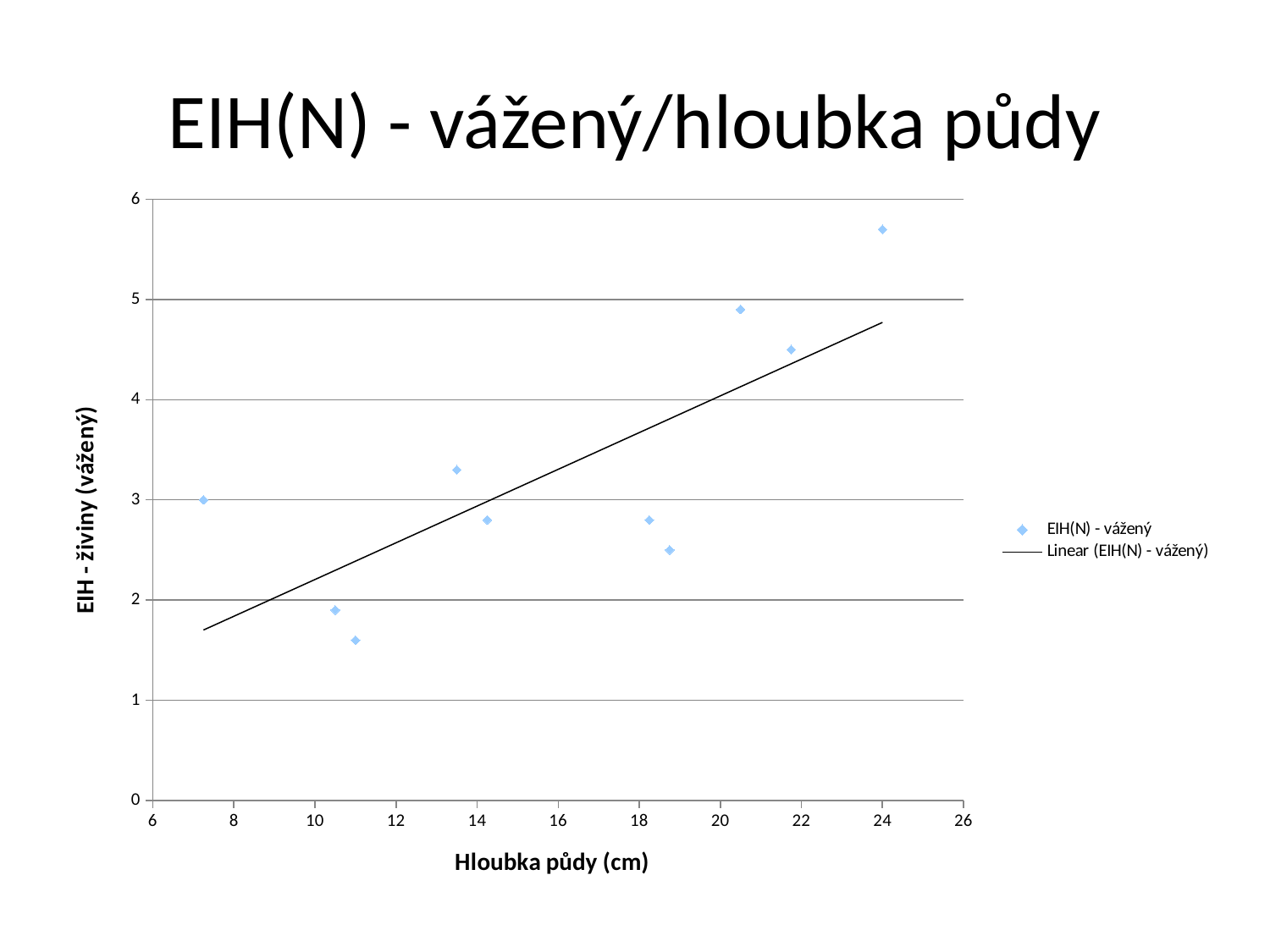
What is the title of the chart? EIH(N) - vážený/hloubka půdy Is the EIH value of the point near 20.5 cm depth greater or less than 4? greater Is the EIH value of the point near 13.5 cm depth greater or less than 3? greater How many data points are plotted in the scatter chart? 10 How many entries does the legend list? 2 Is the EIH value of the point at 24 cm depth greater or less than 5? greater Does the linear trendline rise or fall as soil depth increases? rises What is the label of the x axis? Hloubka půdy (cm) Which point has the higher EIH value: the one near 11 cm depth or the one at 24 cm depth? the one at 24 cm depth What kind of chart is shown on the slide? scatter chart Which point has the highest EIH value? the rightmost point, at 24 cm depth